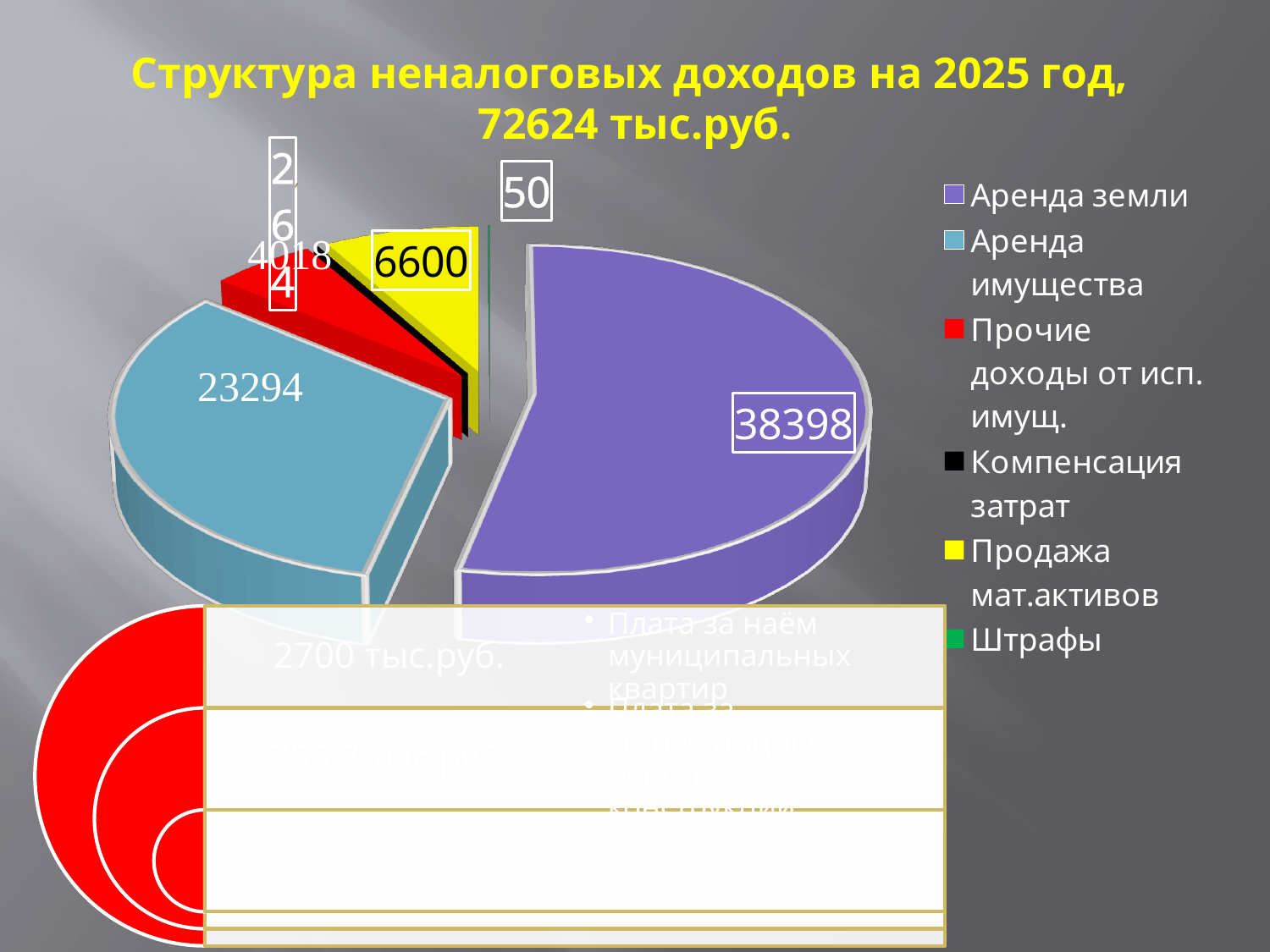
Which is larger, Продажа мат.активов or Прочие доходы от исп. имущ.? Продажа мат.активов What is the value for Штрафы? 50 Which category has the smallest value? Штрафы What is the value for Прочие доходы от исп. имущ.? 4018 What total amount in тыс.руб. is stated in the chart title? 72624 тыс.руб. What is the value for Аренда земли? 38398 What type of chart is shown on the slide? pie chart What is the difference between the values for Аренда земли and Аренда имущества? 15104 What is the value for Продажа мат.активов? 6600 Which category has the largest slice of the pie? Аренда земли How many categories does the legend list? 6 What is the value for Аренда имущества? 23294